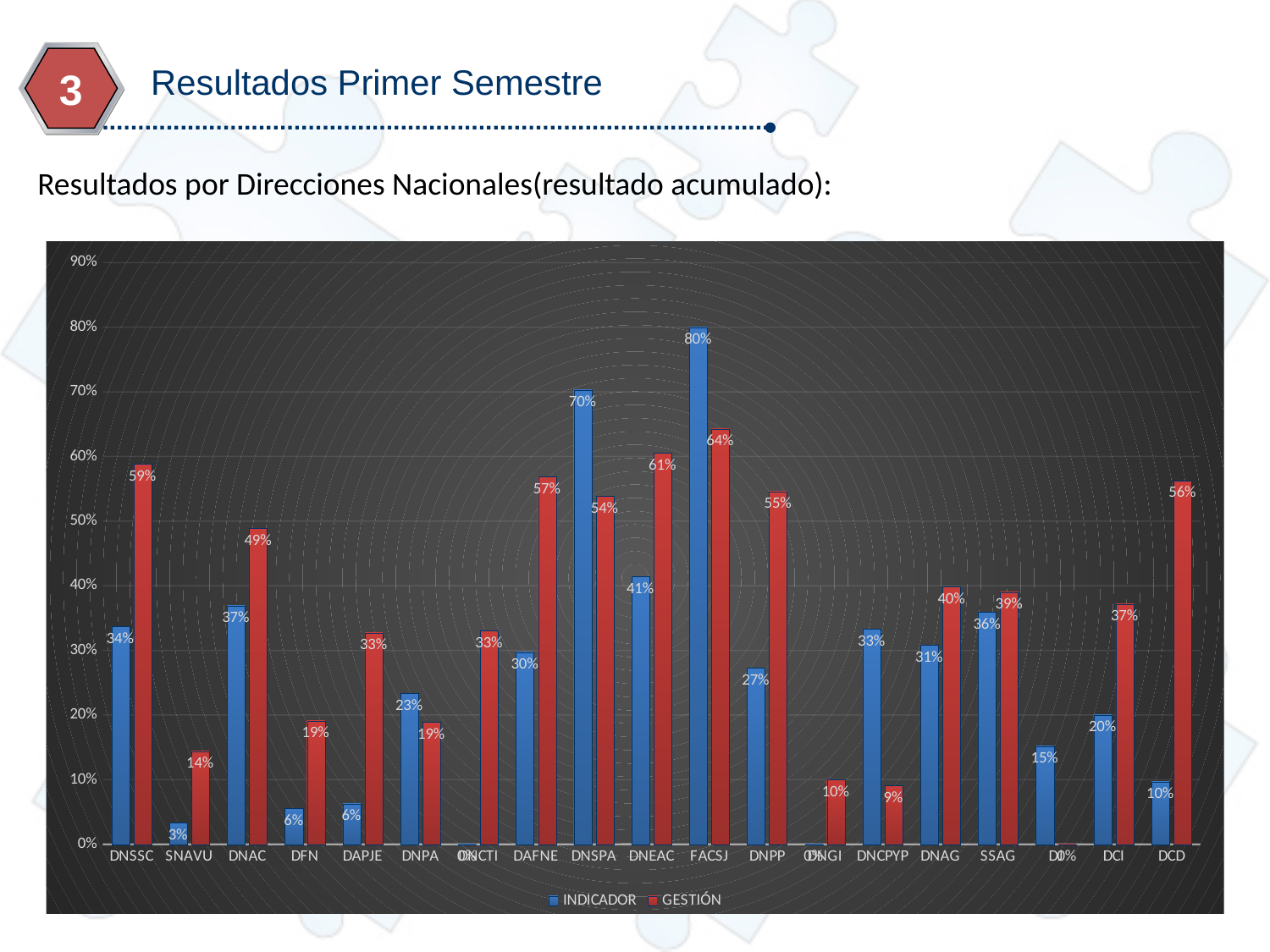
What is the INDICADOR value for SNAVU? 3% For DNSSC, what is the difference between the GESTIÓN value and the INDICADOR value? 25 percentage points What kind of chart is shown on the slide? Bar chart What is the GESTIÓN value for DAFNE? 57% For DNCPYP, which series has the larger value, INDICADOR or GESTIÓN? INDICADOR Which category has the highest INDICADOR value? FACSJ For FACSJ, how much higher is the INDICADOR value than the GESTIÓN value? 16 percentage points What is the INDICADOR value for DNSSC? 34% For DNSPA, which series has the larger value, INDICADOR or GESTIÓN? INDICADOR What is the GESTIÓN value for DCD? 56% How many series does the legend list? 2 Which category has the highest GESTIÓN value? FACSJ